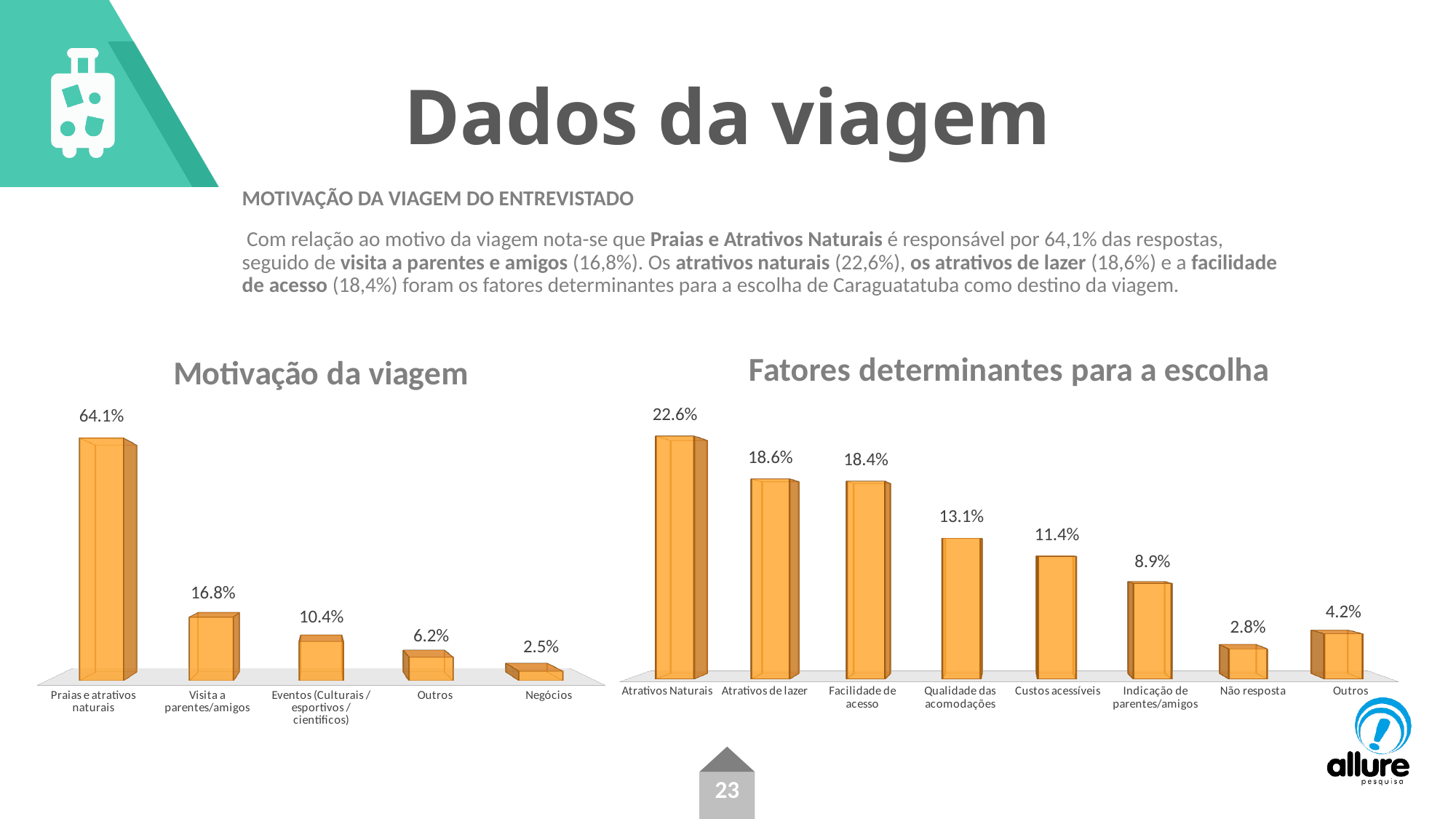
What type of chart is the 'Motivação da viagem' chart? Bar chart In the 'Motivação da viagem' chart, what is the difference between Praias e atrativos naturais and Visita a parentes/amigos? 47.3% In the 'Motivação da viagem' chart, what is the value for Visita a parentes/amigos? 16.8% In the 'Fatores determinantes para a escolha' chart, what is the value for Qualidade das acomodações? 13.1% In the 'Fatores determinantes para a escolha' chart, how many categories are shown? 8 In the 'Fatores determinantes para a escolha' chart, what is the difference between Atrativos Naturais and Atrativos de lazer? 4.0% In the 'Motivação da viagem' chart, how many categories are shown? 5 In the 'Motivação da viagem' chart, which category has the lowest value? Negócios In the 'Fatores determinantes para a escolha' chart, which category has the highest value? Atrativos Naturais In the 'Motivação da viagem' chart, which category has the highest value? Praias e atrativos naturais In the 'Fatores determinantes para a escolha' chart, which category has the lowest value? Não resposta In the 'Fatores determinantes para a escolha' chart, which is larger: Custos acessíveis or Indicação de parentes/amigos? Custos acessíveis